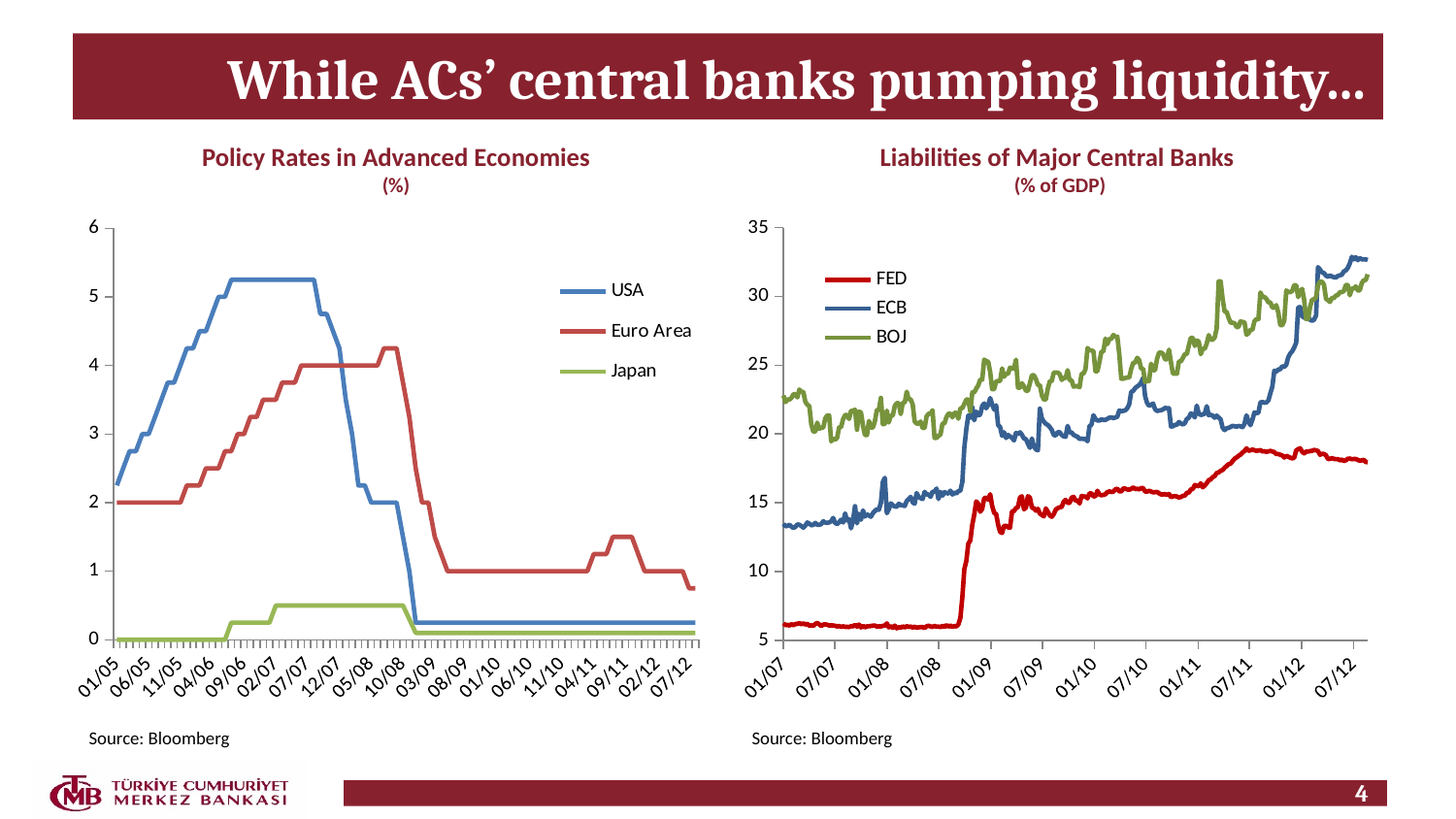
In the 'Liabilities of Major Central Banks' chart, does the FED series rise or fall overall from 01/07 to 07/12? rise In the 'Policy Rates in Advanced Economies' chart, which is larger at 09/06, USA or Euro Area? USA In the 'Policy Rates in Advanced Economies' chart, does the USA series rise or fall between 07/07 and 03/09? fall In the 'Liabilities of Major Central Banks' chart, which series has the lowest value at 07/12? FED In the 'Policy Rates in Advanced Economies' chart, which series has the highest value at 07/12? Euro Area What kind of chart is the 'Policy Rates in Advanced Economies' chart? line chart Which series are listed in the legend of the 'Policy Rates in Advanced Economies' chart? USA, Euro Area, Japan In the 'Policy Rates in Advanced Economies' chart, is the value for Japan at 07/07 greater or less than 1? less In the 'Liabilities of Major Central Banks' chart, is the value for FED at 01/07 greater or less than 10? less In the 'Policy Rates in Advanced Economies' chart, is the value for USA at 09/06 greater or less than 5? greater How many series does the legend of the 'Liabilities of Major Central Banks' chart list? 3